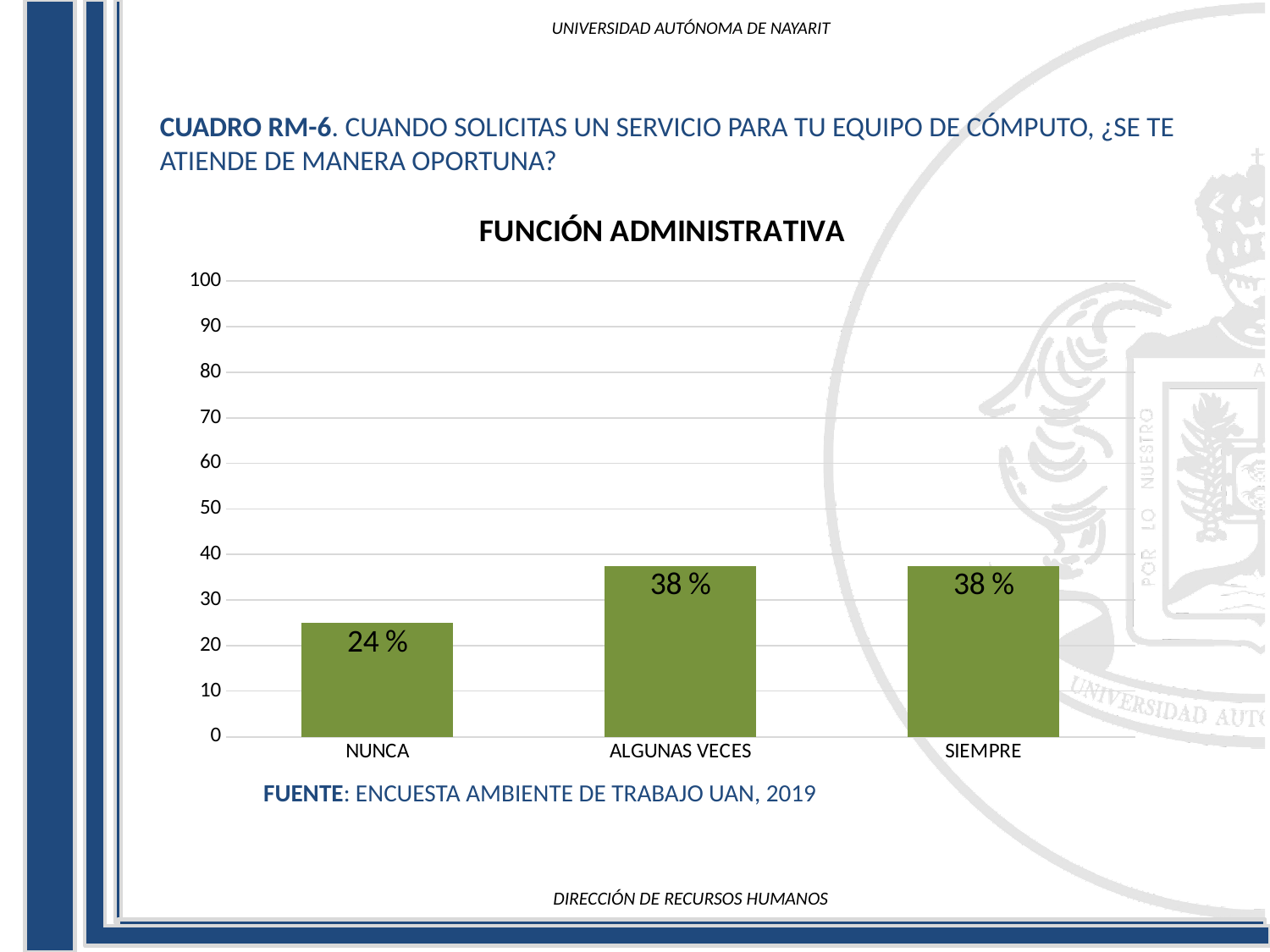
How many categories are shown on the x axis? 3 Which category has the lowest value? NUNCA Which is larger, the value for NUNCA or the value for SIEMPRE? SIEMPRE What is the difference between the values for ALGUNAS VECES and NUNCA? 14 % What is the value for ALGUNAS VECES? 38 % Is the value for SIEMPRE greater or less than 30? greater What is the value for NUNCA? 24 % What is the value for SIEMPRE? 38 % What is the title of the chart? FUNCIÓN ADMINISTRATIVA What is the maximum value shown on the y axis? 100 What kind of chart is shown on the slide? bar chart Is the value for NUNCA greater or less than 30? less